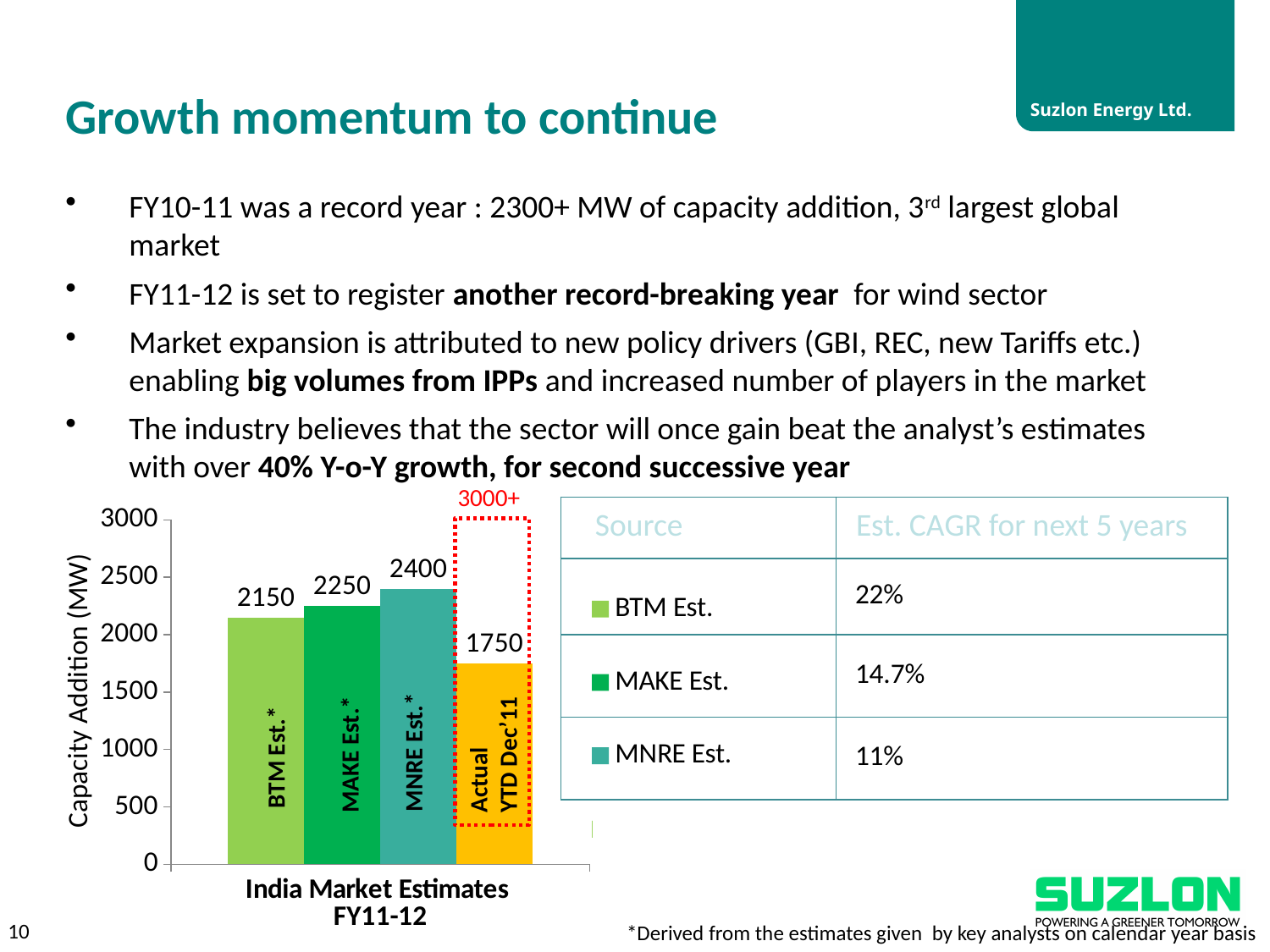
What is the value for BTM Est.* in the India Market Estimates FY11-12 chart? 2150 What is the difference between the MAKE Est.* value and the Actual YTD Dec'11 value? 500 What is the difference between the MNRE Est.* and BTM Est.* values? 250 What is the value for MNRE Est.* in the India Market Estimates FY11-12 chart? 2400 How many bars are plotted in the India Market Estimates FY11-12 chart? 4 What is the value for Actual YTD Dec'11 in the India Market Estimates FY11-12 chart? 1750 Which bar has the highest value in the India Market Estimates FY11-12 chart? MNRE Est.* What is the value for MAKE Est.* in the India Market Estimates FY11-12 chart? 2250 Which bar has the lowest value in the India Market Estimates FY11-12 chart? Actual YTD Dec'11 What is the label of the vertical axis of the chart? Capacity Addition (MW) What type of chart is shown on the slide? bar chart Which is larger, the BTM Est.* value or the MAKE Est.* value? MAKE Est.*